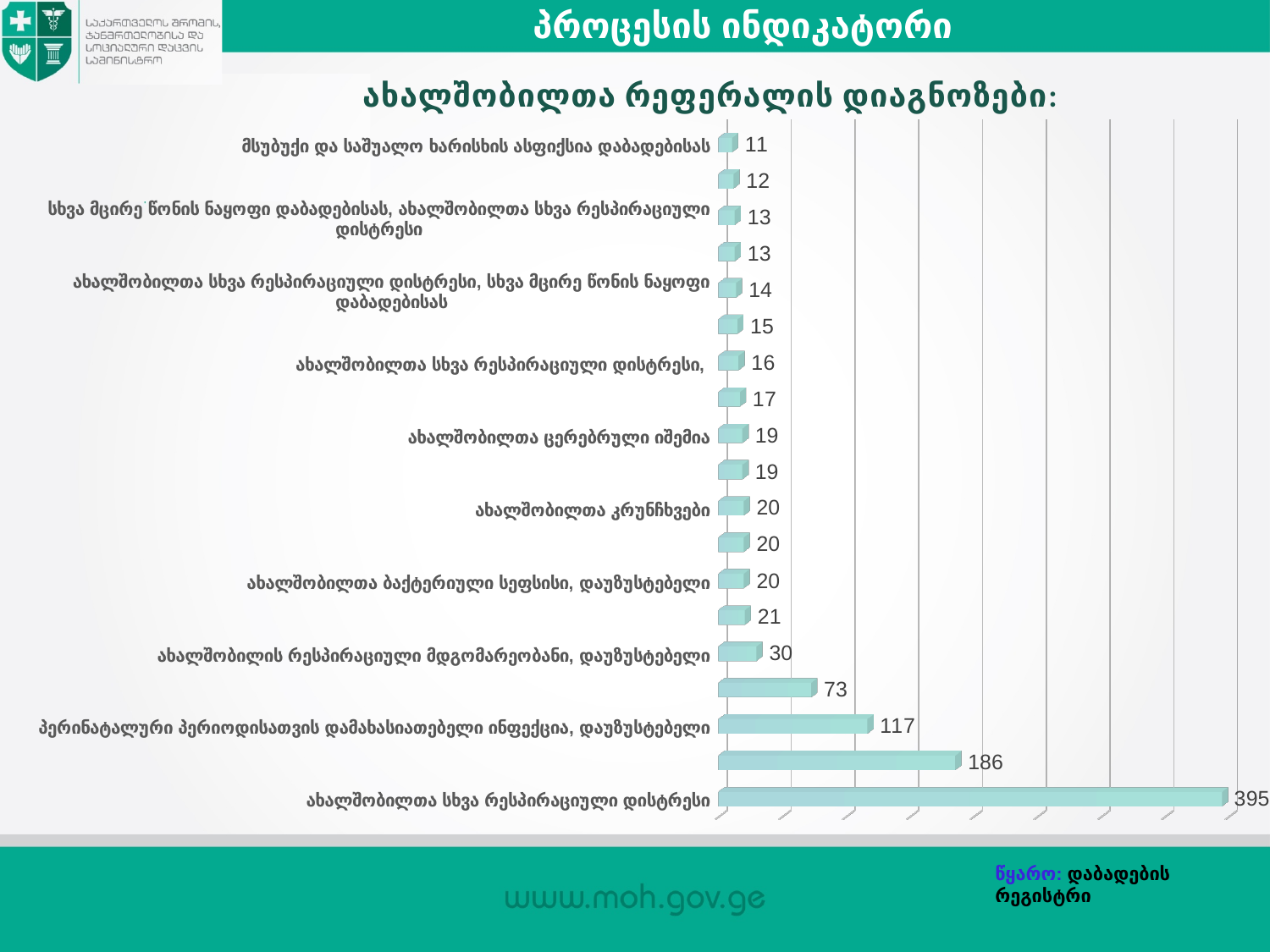
What is the value for ახალშობილთა ცერებრული იშემია? 19 Which is larger: the value for ახალშობილთა კრუნჩხვები or the value for ახალშობილთა ცერებრული იშემია? ახალშობილთა კრუნჩხვები What is the difference between the value for ახალშობილთა სხვა რესპირაციული დისტრესი (395) and the value for პერინატალური პერიოდისათვის დამახასიათებელი ინფექცია, დაუზუსტებელი (117)? 278 What is the title of the chart? ახალშობილთა რეფერალის დიაგნოზები: What type of chart is shown on the slide? bar chart Which category has the lowest value? მსუბუქი და საშუალო ხარისხის ასფიქსია დაბადებისას What is the value for ახალშობილთა სხვა რესპირაციული დისტრესი (the bottom bar)? 395 Which category has the highest value? ახალშობილთა სხვა რესპირაციული დისტრესი How many bars are plotted in the chart? 19 What is the value for მსუბუქი და საშუალო ხარისხის ასფიქსია დაბადებისას? 11 What is the value for პერინატალური პერიოდისათვის დამახასიათებელი ინფექცია, დაუზუსტებელი? 117 What is the value for ახალშობილის რესპირაციული მდგომარეობანი, დაუზუსტებელი? 30